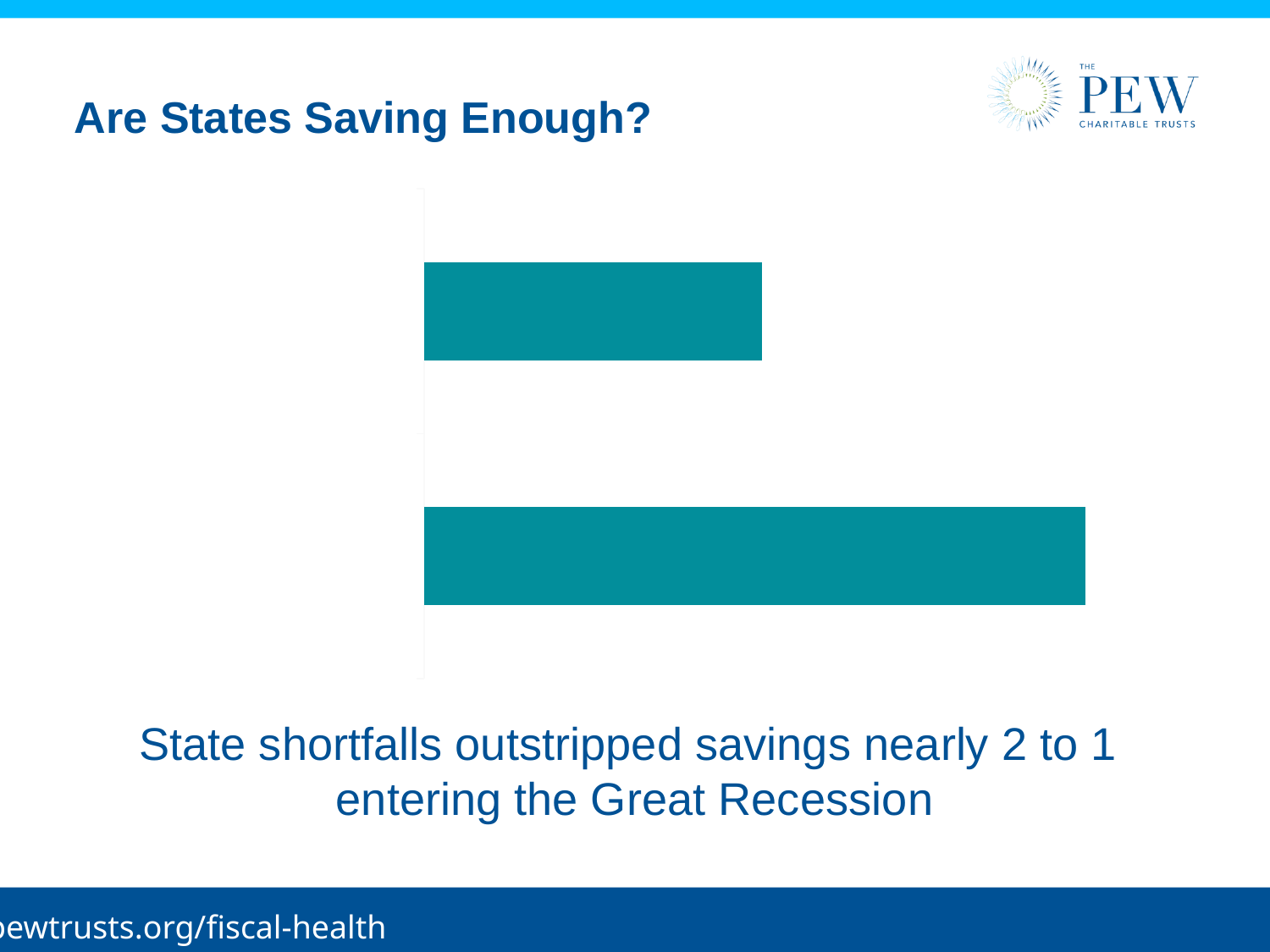
What colour are the bars in the chart? teal What kind of chart is shown on the slide? bar chart How many bars are plotted in the chart? 2 Which bar represents the largest value, the top or the bottom one? the bottom bar Which bar represents the smallest value, the top or the bottom one? the top bar Which bar is longer, the top bar or the bottom bar? the bottom bar Are the bars in the chart oriented horizontally or vertically? horizontally